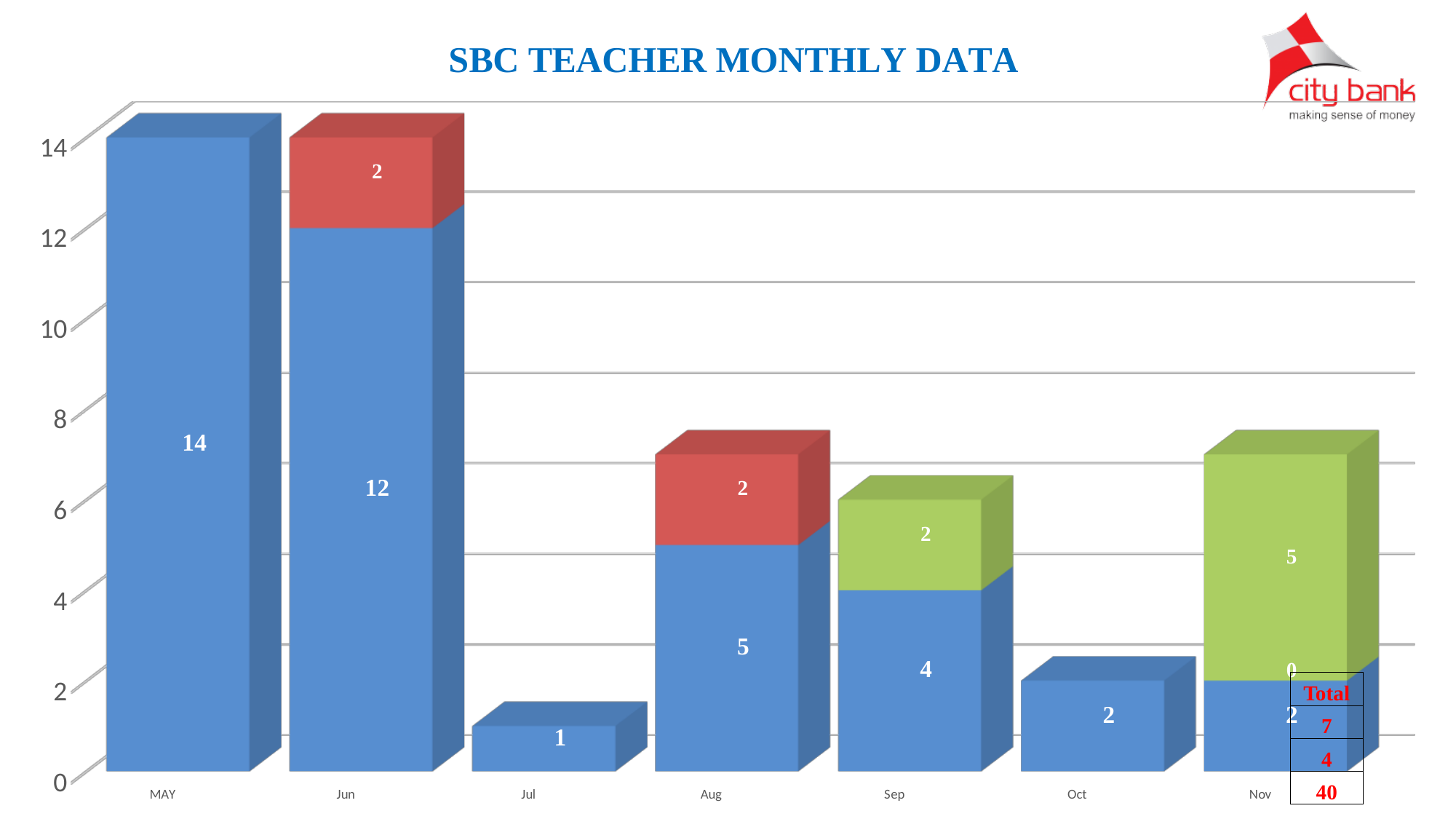
Which is larger, the blue segment for Sep or the blue segment for Oct? Sep How many months are shown on the x axis? 7 What is the value of the blue segment for Jun? 12 What is the value of the green segment for Nov? 5 What type of chart is shown on the slide? Bar chart What is the total of the stacked bar for Jun? 14 Which month has the lowest blue segment value? Jul Which month has the highest blue segment value? MAY What is the difference between the blue segment values for MAY and Jun? 2 What is the value of the blue segment for MAY? 14 What is the total of the stacked bar for Aug? 7 What is the value of the red segment for Aug? 2